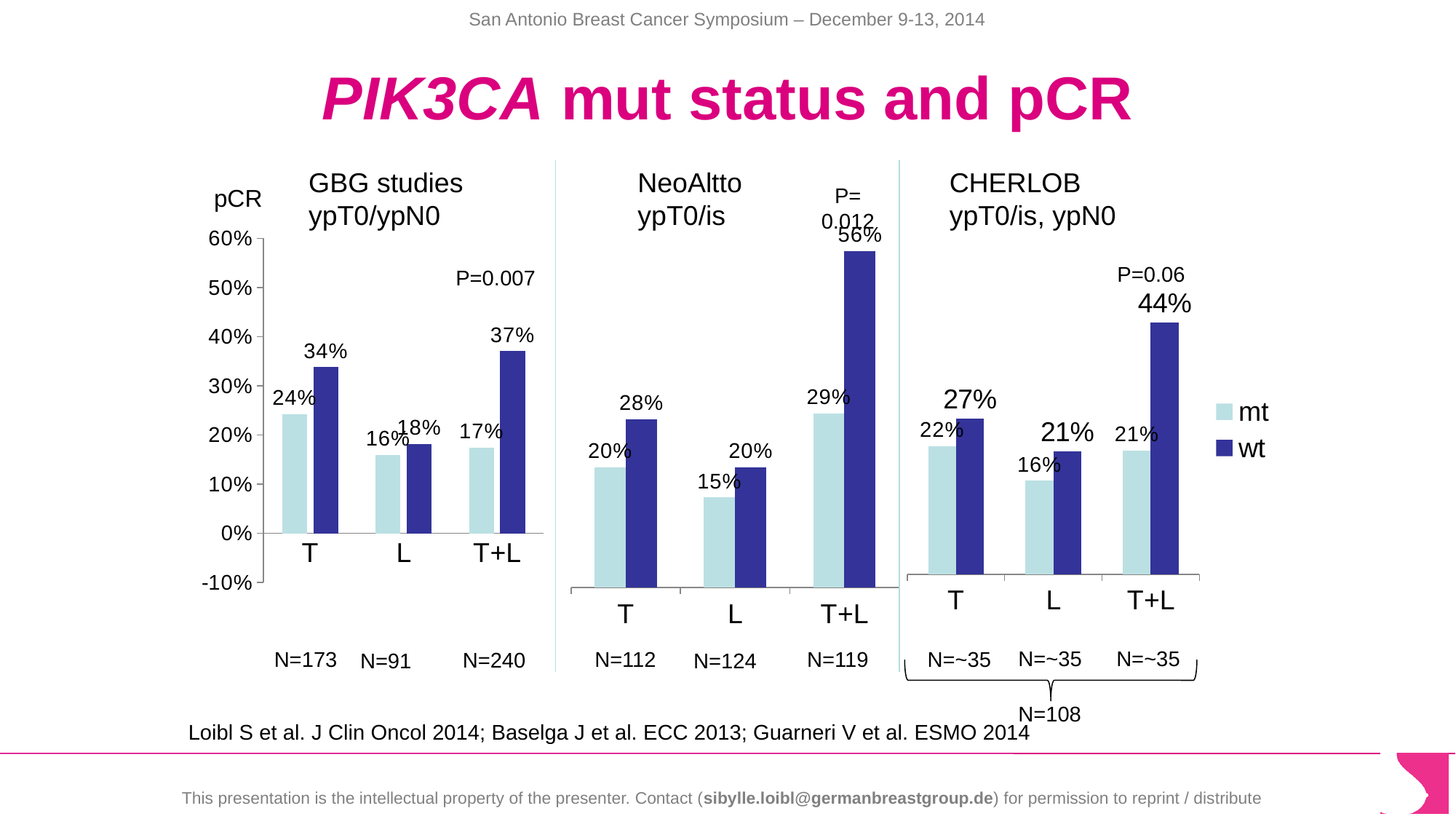
In the NeoAltto chart, what is the pCR rate for wt in the T+L group? 56% What type of chart is used for the GBG studies data? Bar chart In the NeoAltto chart, which group has the lowest mt pCR rate? L How many series does the legend list? 2 How many treatment groups are shown in the CHERLOB chart? 3 In the NeoAltto chart, which group has the highest wt pCR rate? T+L In the GBG studies chart, which is larger in the L group, the mt or the wt pCR rate? wt In the GBG studies chart, what is the pCR rate for wt in the T+L group? 37% In the GBG studies chart, what is the pCR rate for mt in the T group? 24% In the CHERLOB chart, what is the difference between the wt and mt pCR rates in the T+L group? 23% In the CHERLOB chart, what is the pCR rate for mt in the L group? 16% In the GBG studies chart, what is the difference between the wt and mt pCR rates in the T group? 10%